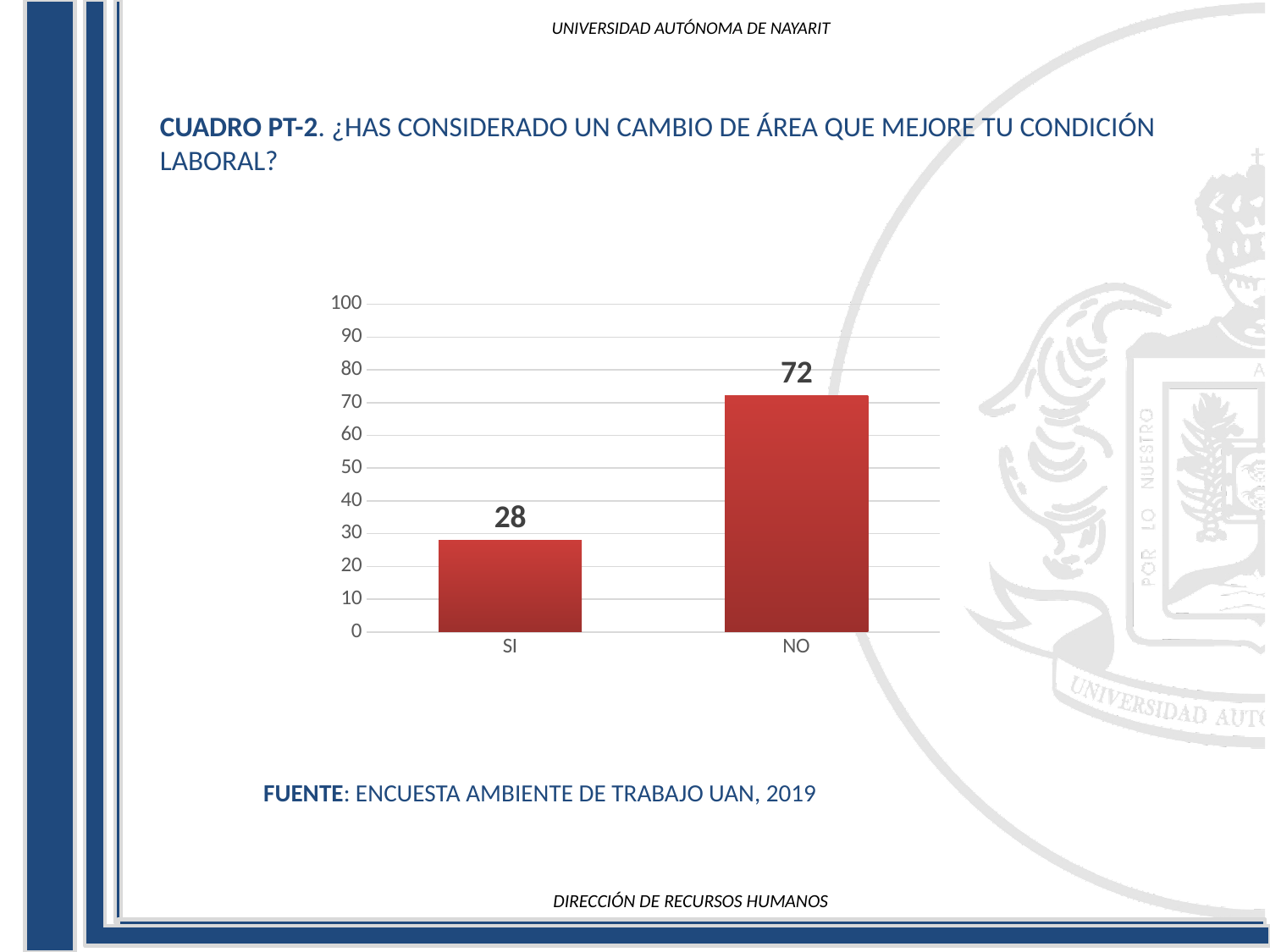
Which category has the lowest value? SI What is the difference between the values for NO and SI? 44 What is the highest value shown on the vertical axis? 100 What is the value for SI? 28 How many categories are shown on the x axis? 2 What is the value for NO? 72 Is the value for NO greater or less than 50? greater What is the source cited below the chart? ENCUESTA AMBIENTE DE TRABAJO UAN, 2019 Is the value for SI greater or less than 40? less Which category has the highest value? NO What kind of chart is shown on the slide? bar chart Which is larger, the value for SI or the value for NO? NO